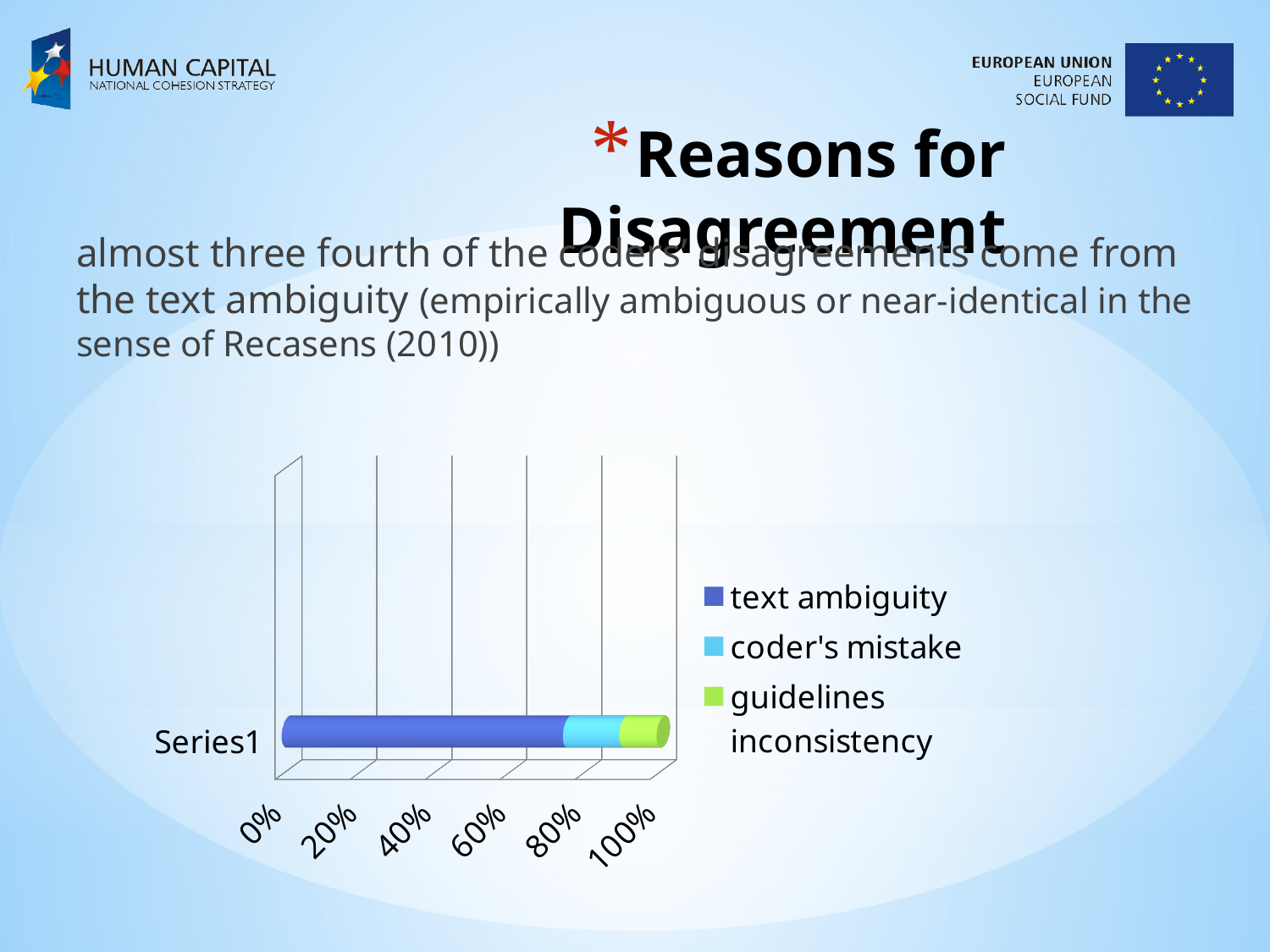
How many categories (bars) are plotted in the chart? 1 Is the value for text ambiguity greater or less than 80%? less What is the highest value shown on the chart's horizontal axis? 100% What kind of chart is shown on the slide? Bar chart Which is larger in the chart: text ambiguity or guidelines inconsistency? text ambiguity Is the value for text ambiguity greater or less than 60%? greater What colour represents text ambiguity in the chart? Dark blue Which is larger in the chart: text ambiguity or coder's mistake? text ambiguity Which series accounts for the largest portion of the stacked bar? text ambiguity Is the value for coder's mistake greater or less than 40%? less How many series does the chart legend list? 3 What is the label of the single category on the chart's vertical axis? Series1